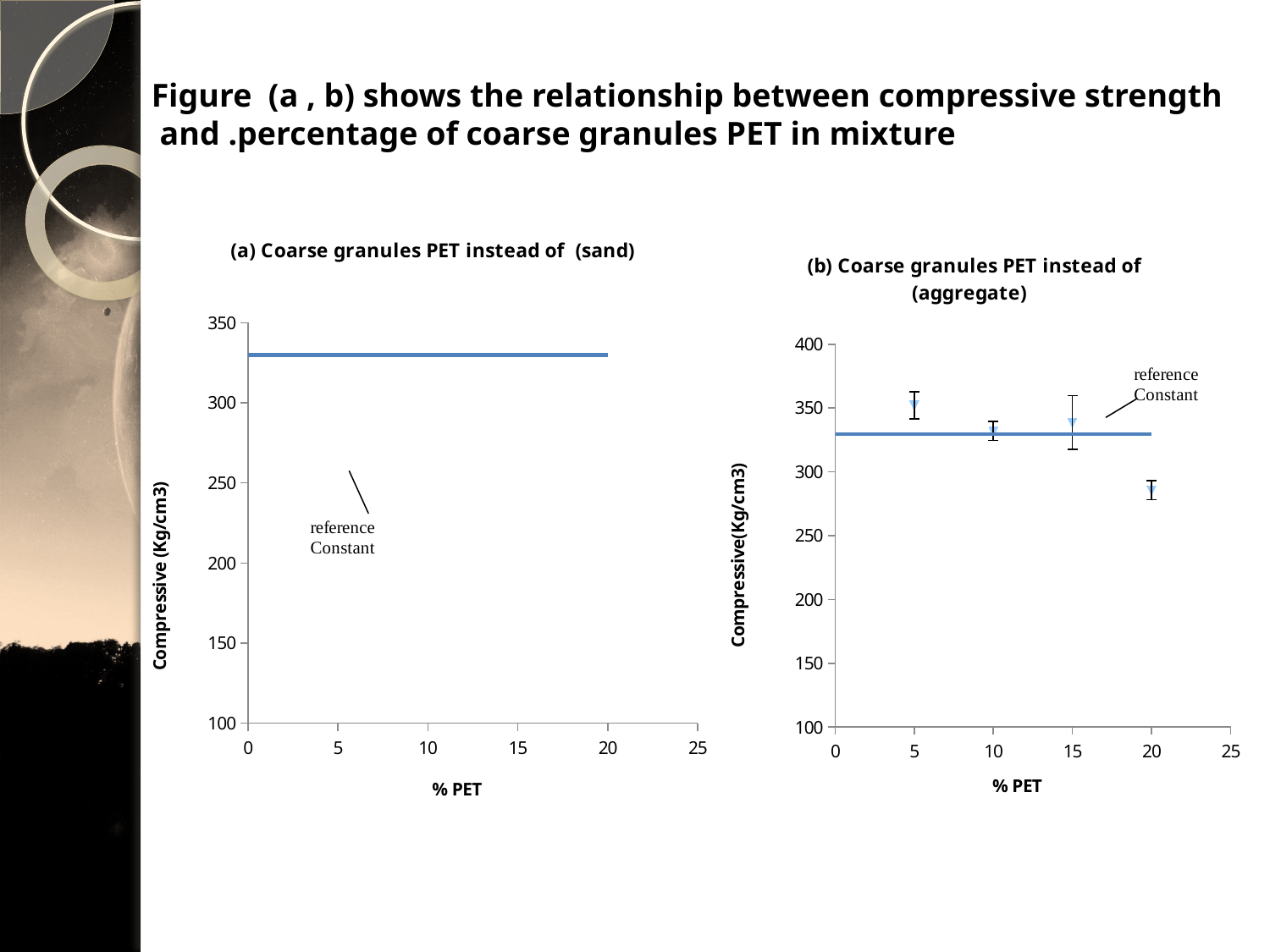
In chart (b) Coarse granules PET instead of (aggregate), is the value at 5% PET greater or less than 300? greater In chart (b) Coarse granules PET instead of (aggregate), at which % PET is the compressive strength highest? 5 In chart (b) Coarse granules PET instead of (aggregate), which has the larger compressive strength, 5% PET or 20% PET? 5% PET What kind of chart is chart (b) Coarse granules PET instead of (aggregate)? scatter chart In chart (b) Coarse granules PET instead of (aggregate), does compressive strength overall rise or fall as % PET increases from 5 to 20? fall In chart (b) Coarse granules PET instead of (aggregate), is the reference constant line greater or less than 350? less What is the x-axis label of chart (a) Coarse granules PET instead of (sand)? % PET In chart (b) Coarse granules PET instead of (aggregate), how many data points are plotted? 4 In chart (a) Coarse granules PET instead of (sand), is the reference constant line greater or less than 300? greater In chart (b) Coarse granules PET instead of (aggregate), at which % PET is the compressive strength lowest? 20